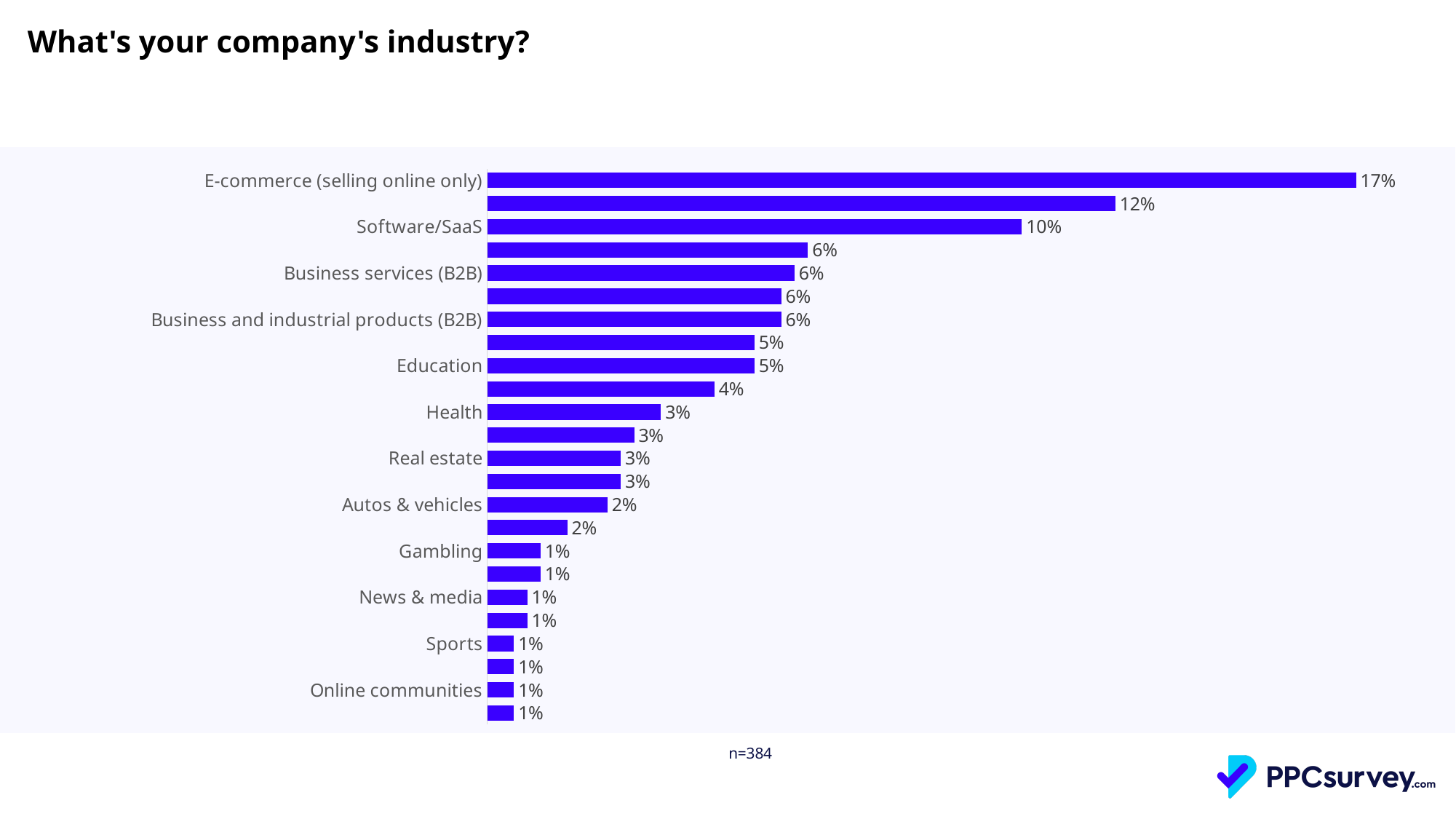
Which labelled industry has the highest share? E-commerce (selling online only) What is the sample size shown below the chart? n=384 What is the value for Education? 5% What is the difference between E-commerce (selling online only) and Software/SaaS? 7% What kind of chart is shown on the slide? Bar chart What percentage of respondents are in E-commerce (selling online only)? 17% What is the value for Software/SaaS? 10% How many bars are plotted in the chart? 24 Which is larger, Education or Real estate? Education What is the value for Health? 3% What is the difference between Software/SaaS and Business services (B2B)? 4% What is the value for Autos & vehicles? 2%